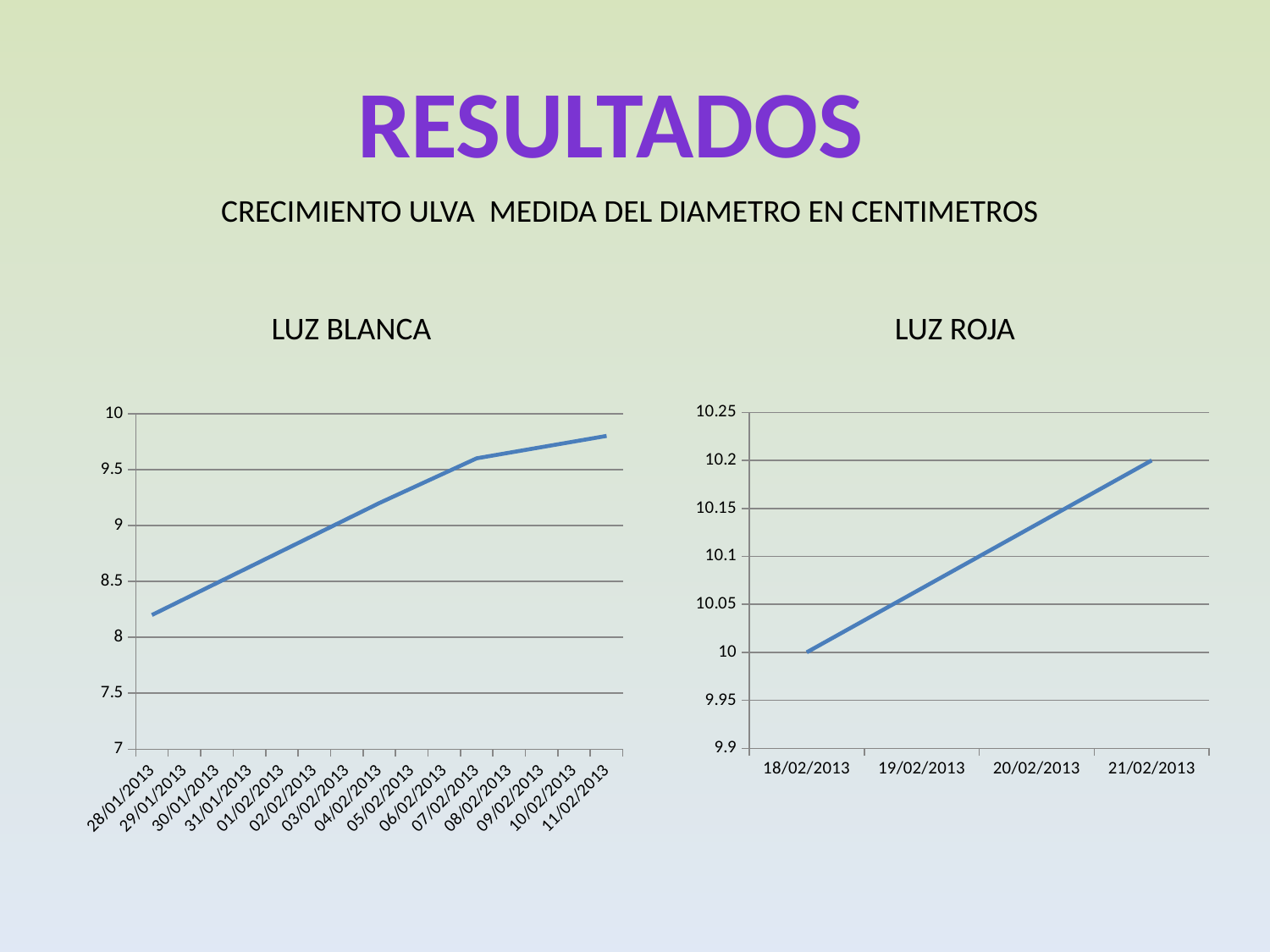
What kind of chart is the LUZ BLANCA chart on the left? line chart What kind of chart is the LUZ ROJA chart on the right? line chart In the LUZ BLANCA chart, how many dates are shown on the x axis? 15 In the LUZ ROJA chart, which date has the highest value? 21/02/2013 In the LUZ BLANCA chart, is the value for 11/02/2013 greater or less than 9.5? greater In the LUZ BLANCA chart, do the values rise or fall from 28/01/2013 to 11/02/2013? rise In the LUZ ROJA chart, do the values rise or fall from 18/02/2013 to 21/02/2013? rise In the LUZ ROJA chart, what is the value for 18/02/2013? 10 In the LUZ BLANCA chart, is the value for 28/01/2013 greater or less than 8.5? less In the LUZ ROJA chart, how many dates are shown on the x axis? 4 In the LUZ ROJA chart, what is the value for 21/02/2013? 10.2 In the LUZ ROJA chart, what is the difference between the values for 21/02/2013 and 18/02/2013? 0.2